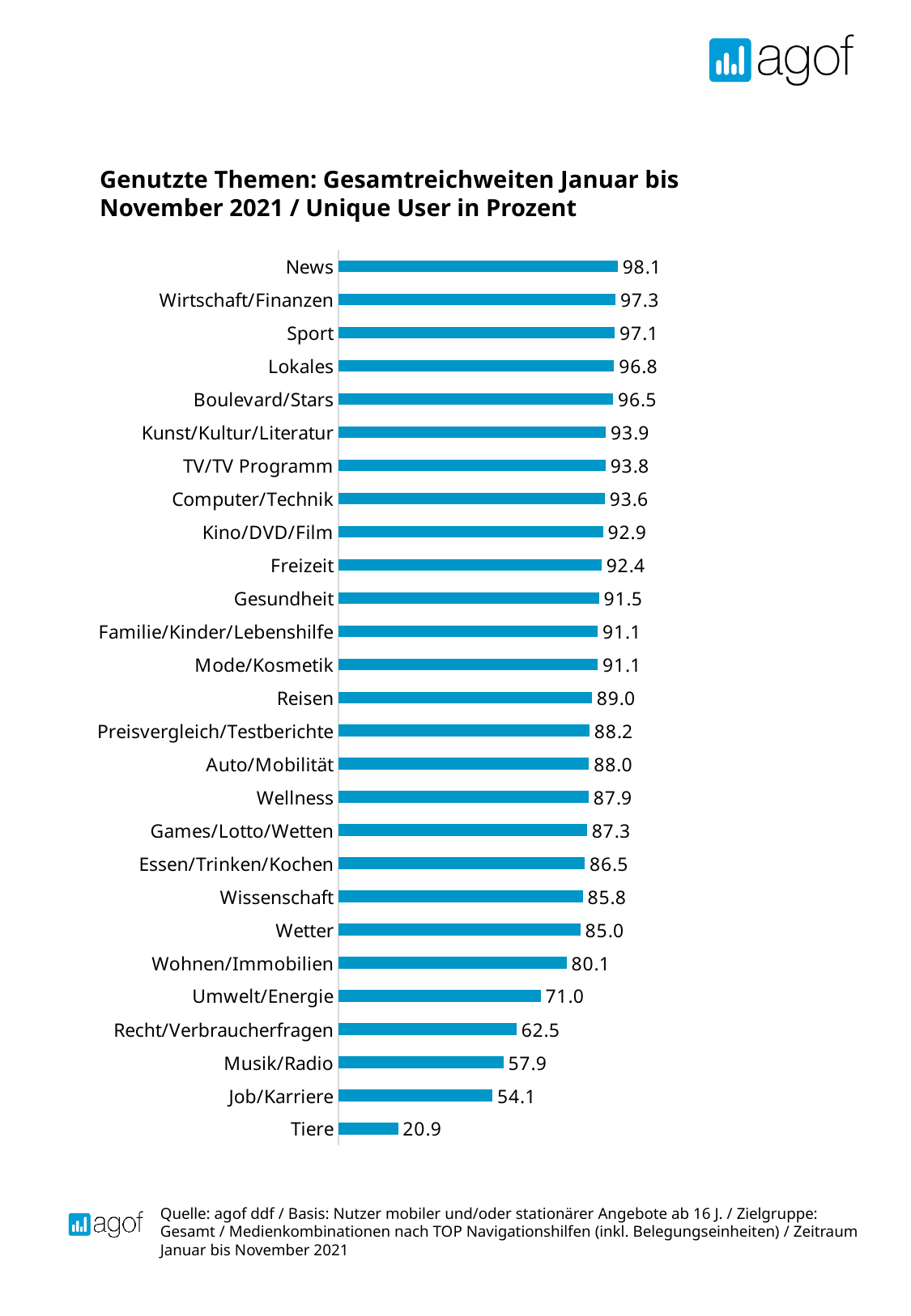
What is the value for Wetter? 85.0 What is the difference between the values for News and Tiere? 77.2 What kind of chart is shown on the slide? Bar chart Which is larger, the value for Wohnen/Immobilien or the value for Recht/Verbraucherfragen? Wohnen/Immobilien What is the value for News? 98.1 Which category has the highest value? News What is the difference between the values for Musik/Radio and Job/Karriere? 3.8 What is the value for Umwelt/Energie? 71.0 What is the title of the chart? Genutzte Themen: Gesamtreichweiten Januar bis November 2021 / Unique User in Prozent How many categories are shown in the chart? 27 Which category has the lowest value? Tiere What is the value for Tiere? 20.9